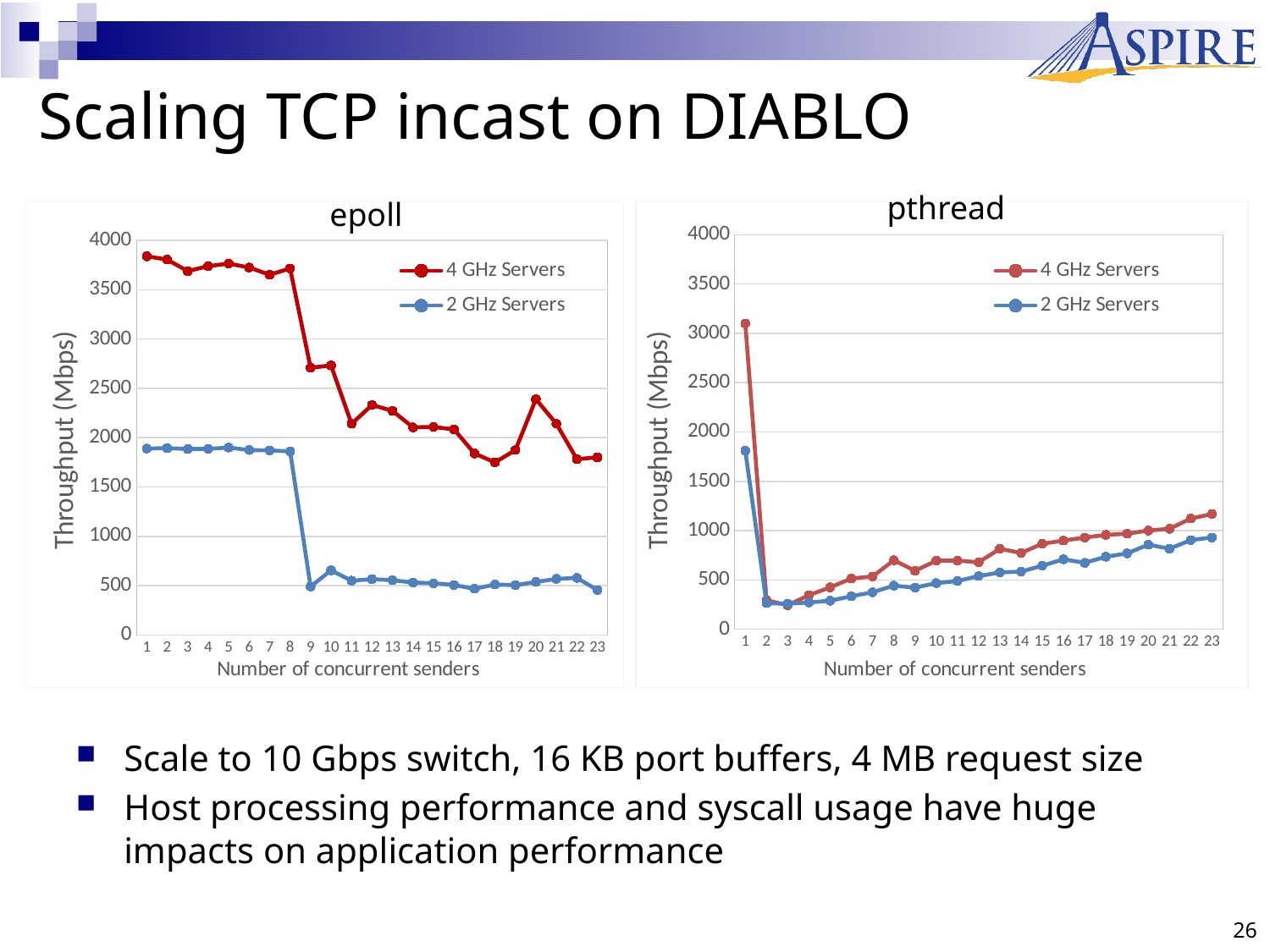
How many series does the legend of the pthread chart list? 2 In the epoll chart, which series has the larger value at 8 concurrent senders, 4 GHz Servers or 2 GHz Servers? 4 GHz Servers In the pthread chart, at which number of concurrent senders is the 4 GHz Servers series highest? 1 In the pthread chart, is the value for 4 GHz Servers at 1 concurrent sender greater or less than 3000? greater How many values of 'Number of concurrent senders' are plotted along the x axis of the epoll chart? 23 In the epoll chart, is the value for 4 GHz Servers at 1 concurrent sender greater or less than 3500? greater In the pthread chart, does the 2 GHz Servers series rise or fall from 2 to 23 concurrent senders? rise In the epoll chart, does the 4 GHz Servers series generally rise or fall from 1 to 23 concurrent senders? fall In the epoll chart, is the value for 2 GHz Servers at 1 concurrent sender greater or less than 1500? greater What kind of chart is the epoll chart? line chart What is the y-axis label of the pthread chart? Throughput (Mbps)